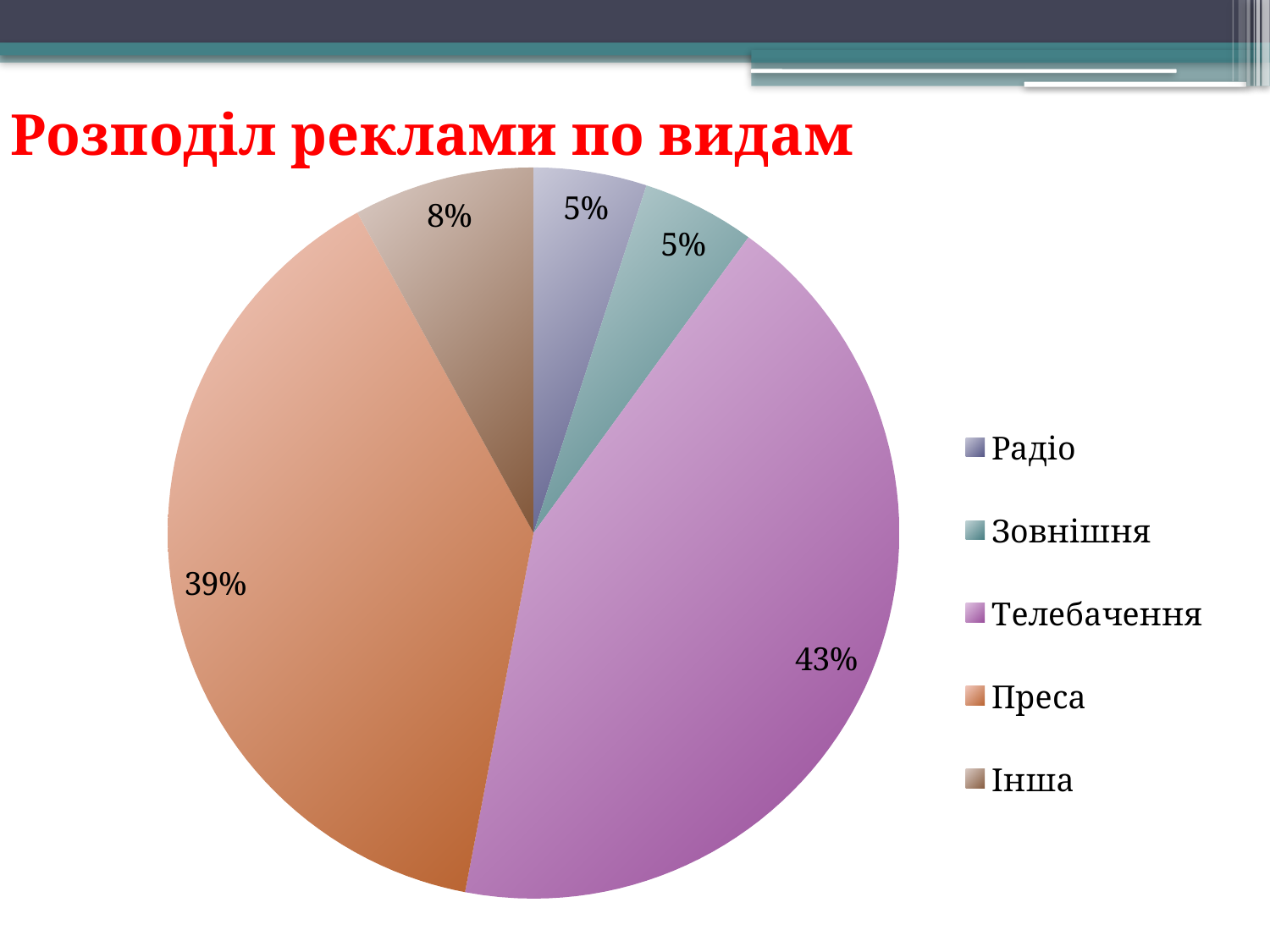
What is the title of the chart? Розподіл реклами по видам What colour is the Телебачення slice? Purple What percentage does the Радіо slice show? 5% What is the value of the Інша slice? 8% How many categories does the pie chart show? 5 What percentage is shown for Преса? 39% What is the difference in percentage points between Телебачення and Преса? 4 Which is larger, the Преса slice or the Інша slice? Преса Which category has the largest slice of the pie? Телебачення What share of the pie does Телебачення have? 43% Which two categories share the smallest slice of the pie? Радіо and Зовнішня What type of chart is shown on the slide? Pie chart